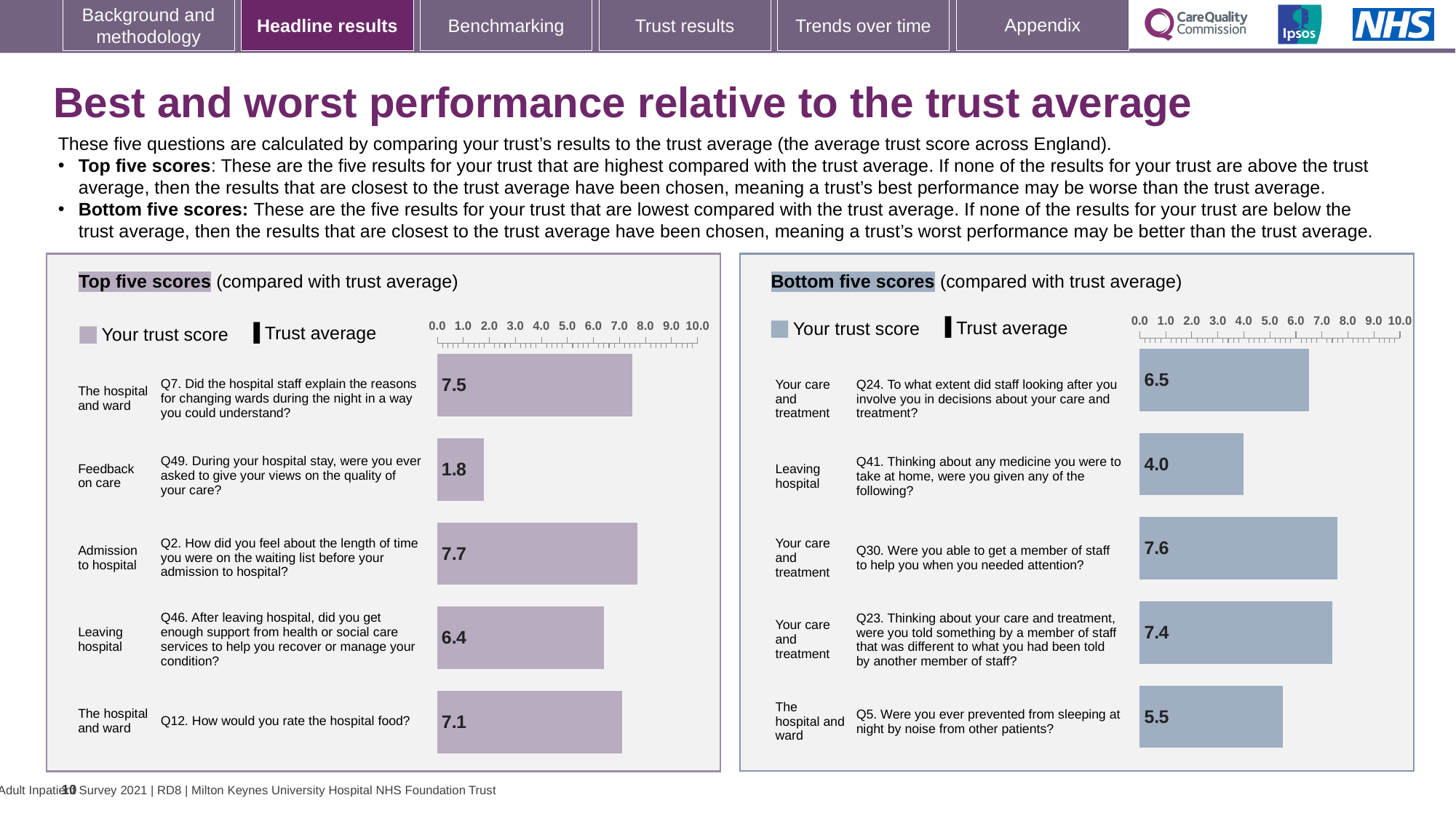
In the Top five scores chart, which question has the lowest trust score? Q49 (1.8) In the Bottom five scores chart, which question has the lowest trust score? Q41 (4.0) In the Bottom five scores chart, which question has the highest trust score? Q30 (7.6) How many series does the legend of the Top five scores chart list? 2 In the Top five scores chart, what is the trust score for Q12, how would you rate the hospital food? 7.1 In the Bottom five scores chart, what is the trust score for Q41 about medicine to take at home? 4.0 How many questions are plotted in the Top five scores chart? 5 What kind of chart is the Bottom five scores chart? Bar chart In the Top five scores chart, what is the difference between the scores for Q7 and Q49? 5.7 In the Top five scores chart, which question has the highest trust score? Q2 (7.7) In the Bottom five scores chart, what is the difference between the scores for Q30 and Q23? 0.2 In the Bottom five scores chart, which has the larger score: Q24 or Q5? Q24